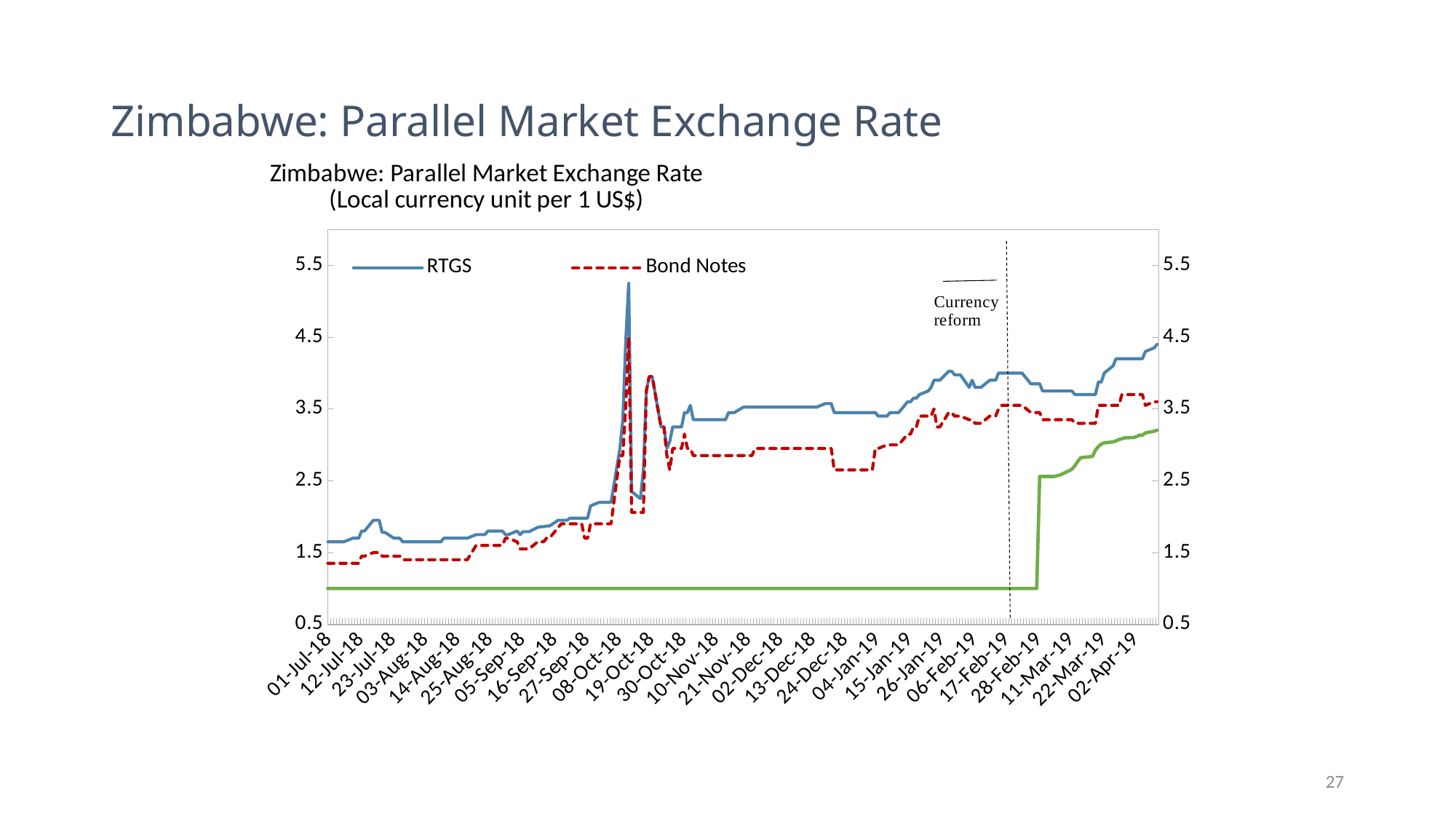
Is the value of the green line before 28-Feb-19 greater or less than 1.5? less How many series does the chart's legend list? 2 Is the value of RTGS at 01-Jul-18 greater or less than 1.5? greater What kind of chart is shown on the slide? Line chart Is the value of the green line at 02-Apr-19 greater or less than 3.5? less At 01-Jul-18, which series has the higher value, RTGS or Bond Notes? RTGS Which two series are named in the chart's legend? RTGS and Bond Notes What event does the dashed vertical line annotation in the chart mark? Currency reform Overall, does the RTGS series rise or fall from 01-Jul-18 to 02-Apr-19? Rise Around 24-Dec-18, which series has the higher value, RTGS or Bond Notes? RTGS